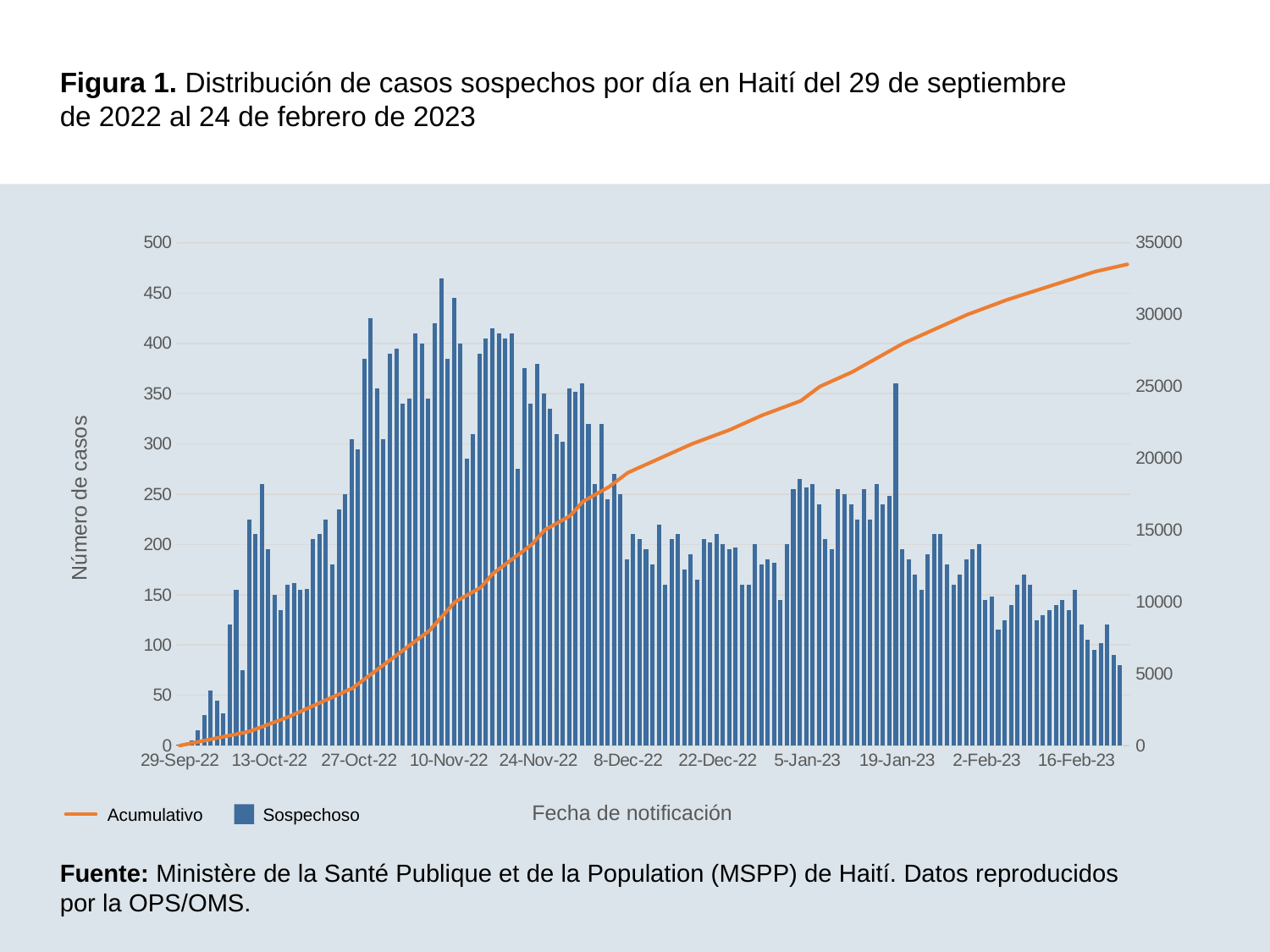
What kind of chart is shown on the slide? A combined bar and line chart Is the highest Sospechoso bar greater or less than 400? greater Is the Sospechoso bar at 16-Feb-23 greater or less than 200? less Is the value of the Acumulativo line at 16-Feb-23 greater or less than 30000? greater How many series does the legend list? 2 What is the title of the x axis? Fecha de notificación How many date labels are shown on the x axis? 11 Which series is drawn as the orange line, according to the legend? Acumulativo Which series is drawn as bars, according to the legend? Sospechoso Does the Acumulativo line rise or fall along the x axis? Rises